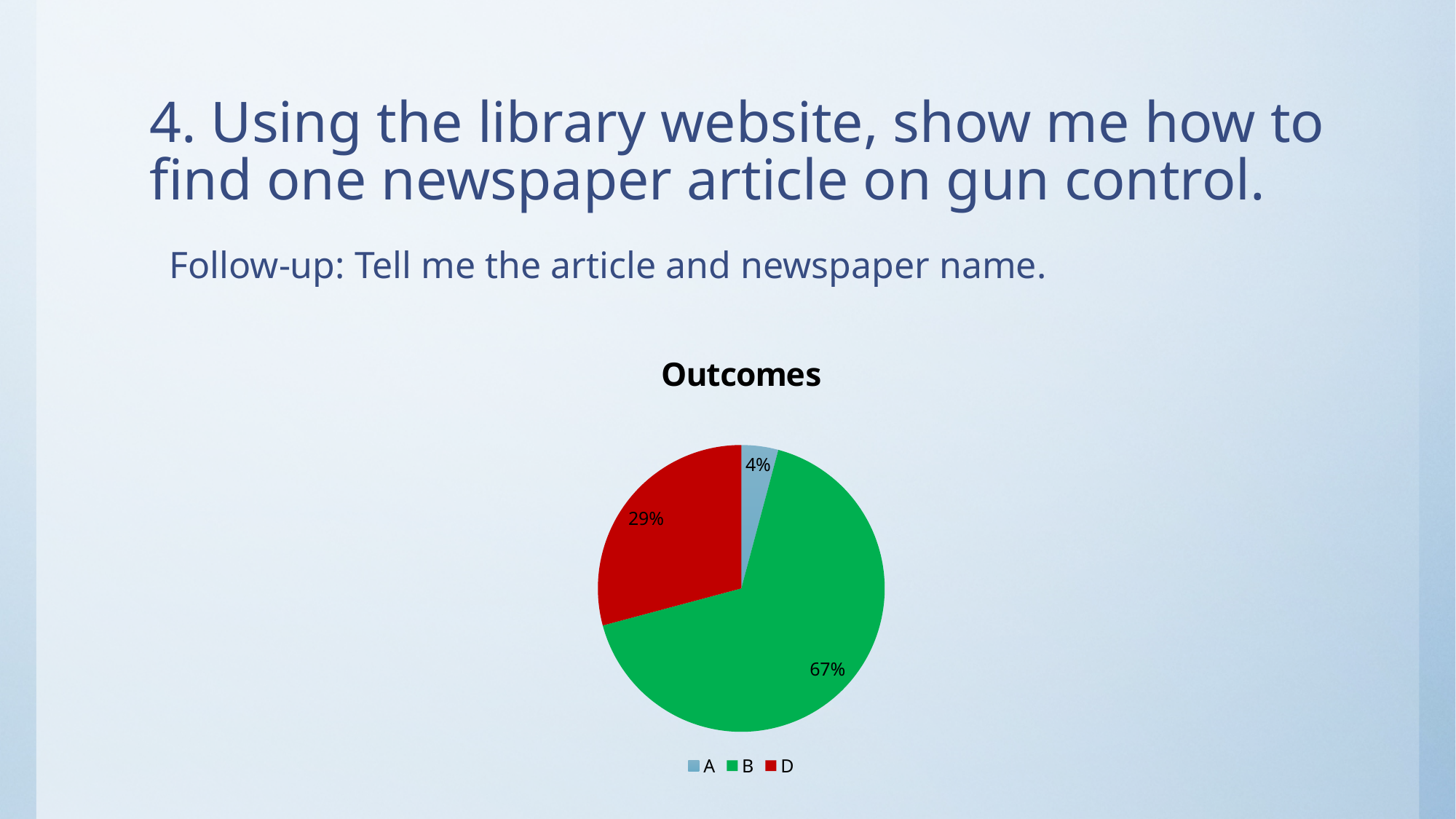
Which category has the smallest slice of the pie? A What share of the pie does category B have? 67% What is the difference in percentage points between D and A? 25 What colour is the slice for category D? red What share of the pie does category D have? 29% What is the difference in percentage points between B and D? 38 Which is larger, the slice for D or the slice for A? D What kind of chart is shown on the slide? pie chart How many categories does the legend list? 3 What is the title of the chart? Outcomes Which category has the largest slice of the pie? B What share of the pie does category A have? 4%